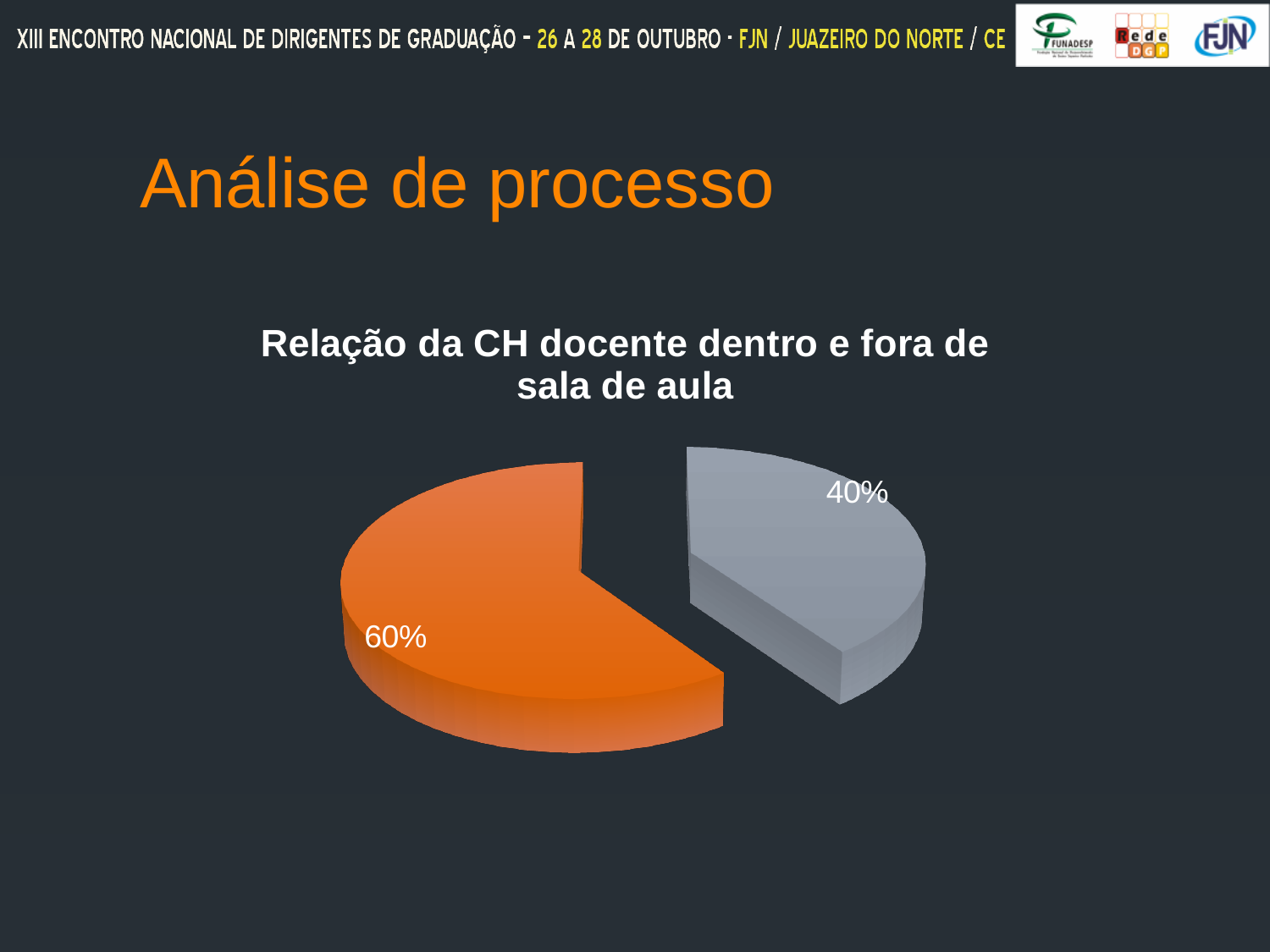
Which slice of the pie chart is the largest? the orange slice (60%) What colour is the slice labelled 40%? grey Which slice of the pie chart is the smallest? the grey slice (40%) What is the title of the chart? Relação da CH docente dentro e fora de sala de aula What kind of chart is shown on the slide? pie chart What value is shown on the grey slice of the pie chart? 40% Which is larger, the orange slice or the grey slice? the orange slice What is the difference in percentage points between the orange slice and the grey slice? 20 percentage points What share of the pie does the grey slice represent? 40% What value is shown on the orange slice of the pie chart? 60% How many slices does the pie chart have? 2 Is the value of the orange slice greater or less than 50%? greater